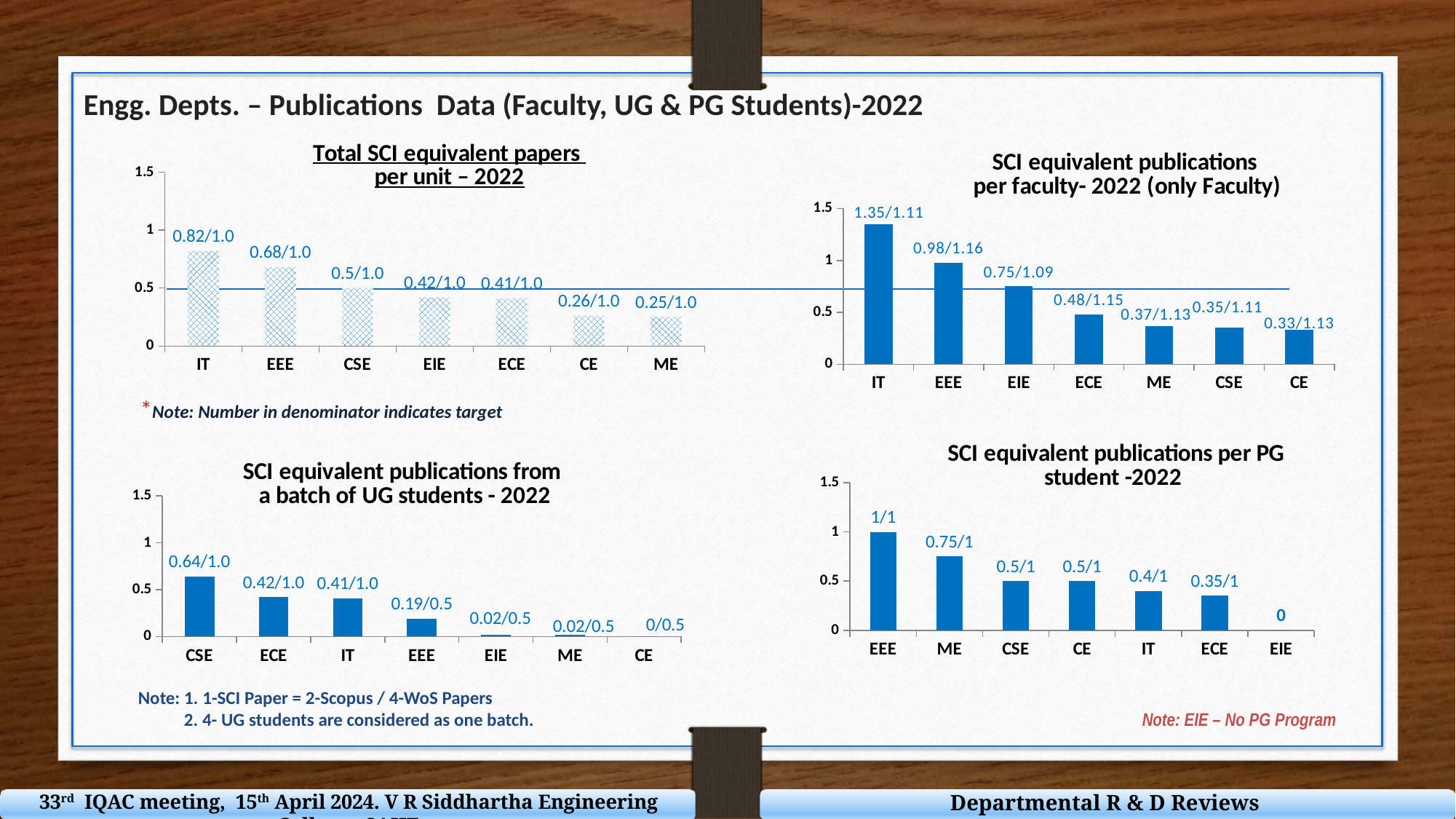
In the 'SCI equivalent publications per faculty- 2022 (only Faculty)' chart, what is the data label shown for EEE? 0.98/1.16 In the 'SCI equivalent publications per PG student -2022' chart, what is the data label shown for ME? 0.75/1 How many departments are shown in the 'Total SCI equivalent papers per unit – 2022' chart? 7 In the 'Total SCI equivalent papers per unit – 2022' chart, what is the data label shown for IT? 0.82/1.0 What type of chart is the 'SCI equivalent publications per PG student -2022' chart? Bar chart In the 'SCI equivalent publications from a batch of UG students - 2022' chart, what is the data label shown for EEE? 0.19/0.5 In the 'SCI equivalent publications from a batch of UG students - 2022' chart, which is larger, the value for ECE or the value for EEE? ECE In the 'SCI equivalent publications from a batch of UG students - 2022' chart, which department has the highest value? CSE In the 'SCI equivalent publications per PG student -2022' chart, what value is shown for EIE? 0 In the 'SCI equivalent publications per faculty- 2022 (only Faculty)' chart, is the value for IT greater or less than 1? greater In the 'Total SCI equivalent papers per unit – 2022' chart, which department has the lowest value? ME In the 'SCI equivalent publications per faculty- 2022 (only Faculty)' chart, which department has the highest value? IT